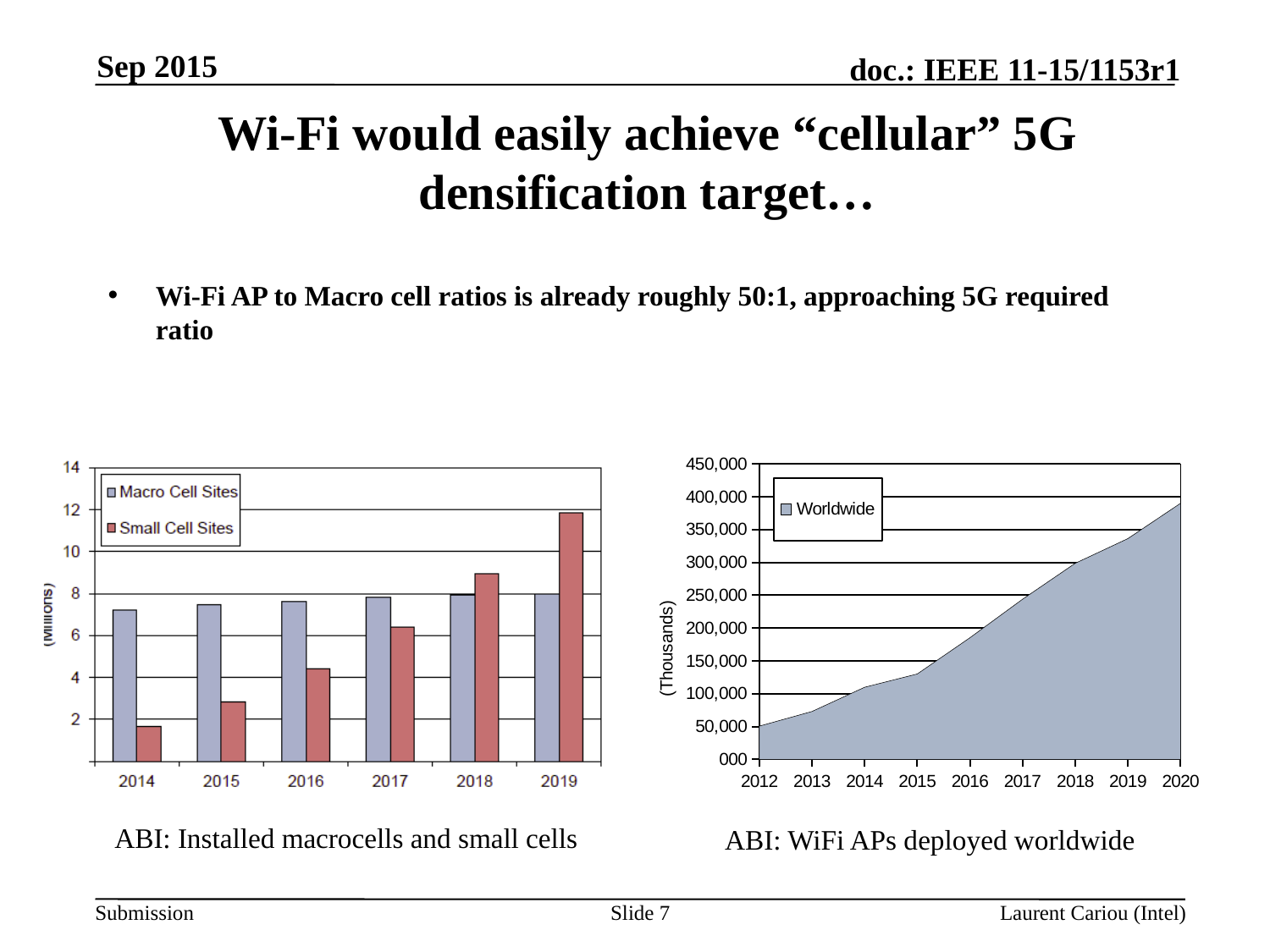
In the left chart (Installed macrocells and small cells), how many series does the legend list? 2 In the left chart (Installed macrocells and small cells), which year has the lowest Small Cell Sites value? 2014 In the left chart (Installed macrocells and small cells), is the Macro Cell Sites value for 2014 greater or less than 8? less In the right chart (WiFi APs deployed worldwide), how many years are shown on the x axis? 9 In the left chart (Installed macrocells and small cells), which is larger in 2018: Macro Cell Sites or Small Cell Sites? Small Cell Sites In the left chart (Installed macrocells and small cells), is the Small Cell Sites value for 2019 greater or less than 10? greater What kind of chart is the right chart (ABI: WiFi APs deployed worldwide)? area chart In the left chart (Installed macrocells and small cells), which year has the highest Small Cell Sites value? 2019 In the right chart (WiFi APs deployed worldwide), is the value for 2020 greater or less than 350,000? greater In the right chart (WiFi APs deployed worldwide), do the values rise or fall from 2012 to 2020? rise What kind of chart is the left chart (ABI: Installed macrocells and small cells)? bar chart In the left chart (Installed macrocells and small cells), how many years are shown on the x axis? 6